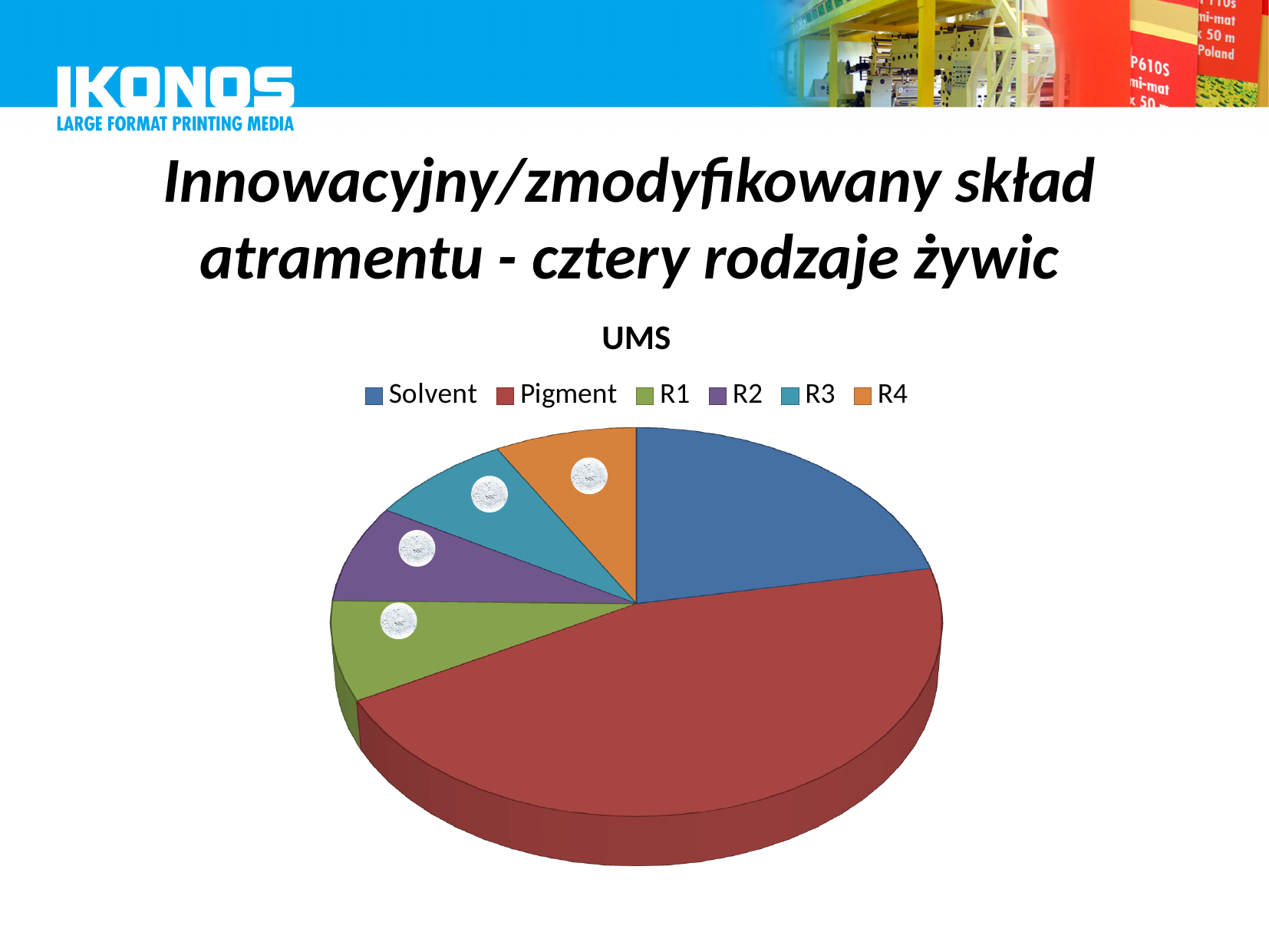
Which is larger, the Solvent slice or the R1 slice? Solvent Which is larger, the Solvent slice or the R3 slice? Solvent Which is larger, the Pigment slice or the R4 slice? Pigment What kind of chart is shown on the slide? pie chart What colour is the Pigment slice? red What is the title of the chart? UMS How many slices does the pie chart have? 6 How many entries does the legend list? 6 Which category has the largest slice of the pie? Pigment